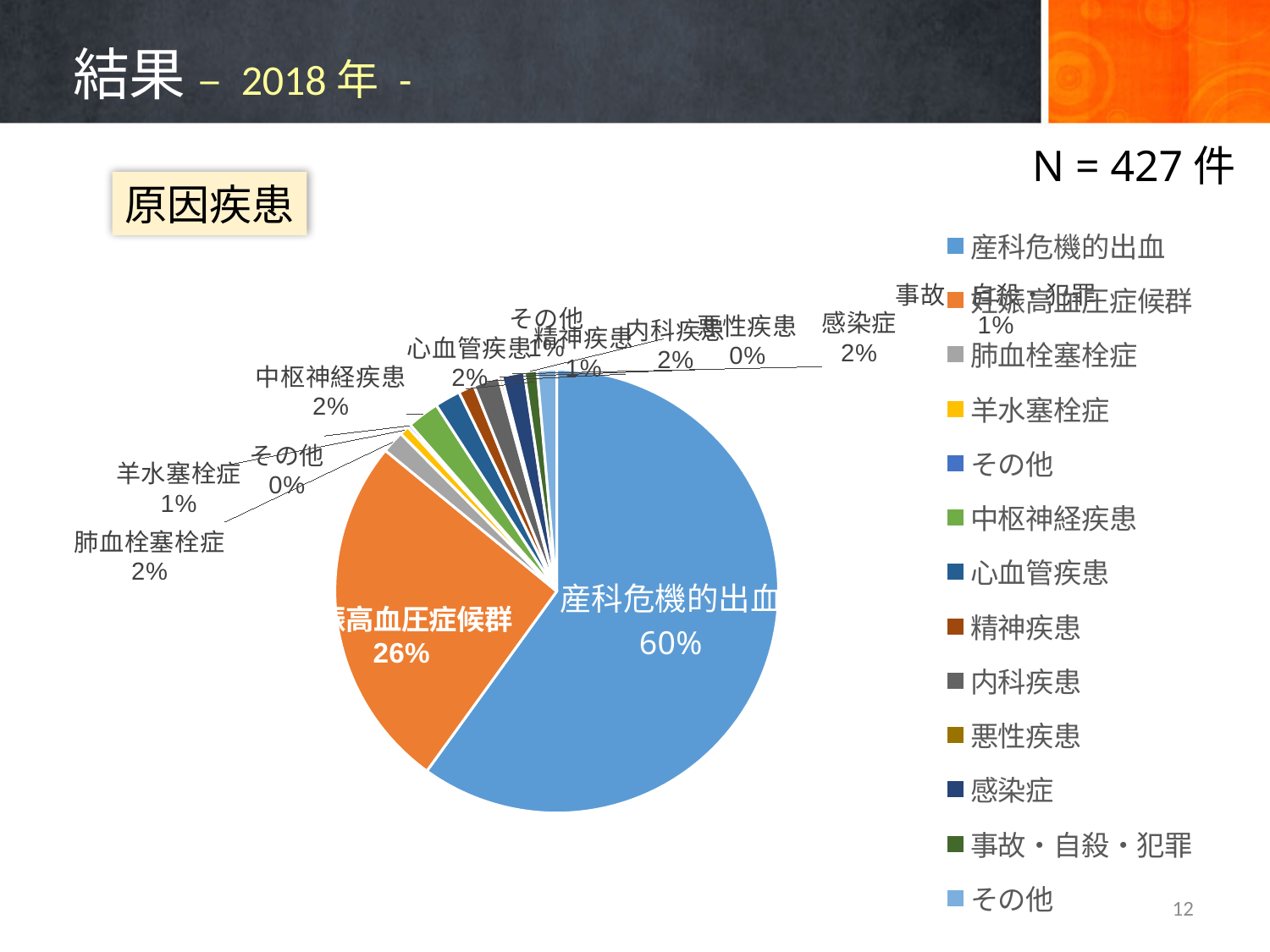
What is the difference in percentage points between 産科危機的出血 and 妊娠高血圧症候群? 34 percentage points What is the total number of cases (N) stated on the slide? N = 427 件 Which category has the largest slice of the pie? 産科危機的出血 What is the value shown for 羊水塞栓症? 1% How many entries does the legend list? 13 What is the value shown for 中枢神経疾患? 2% Which is larger, the slice for 妊娠高血圧症候群 or the slice for 肺血栓塞栓症? 妊娠高血圧症候群 What share of the pie does 産科危機的出血 account for? 60% What is the value shown for 感染症? 2% What kind of chart is shown on the slide? Pie chart What is the value shown for 肺血栓塞栓症? 2% What share of the pie does 妊娠高血圧症候群 account for? 26%